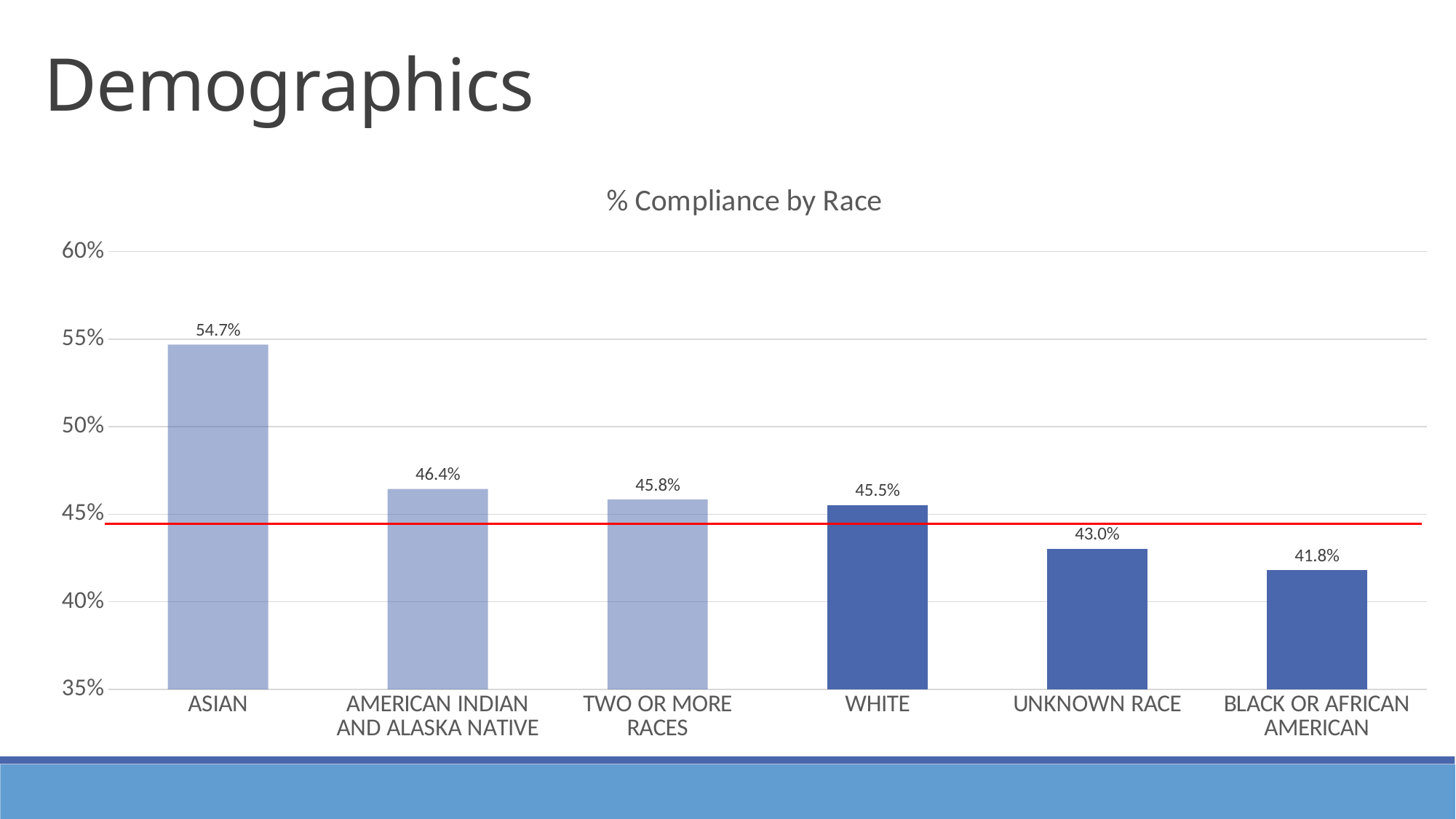
What is the title of the chart? % Compliance by Race What kind of chart is shown on the slide? Bar chart What is the % compliance value for BLACK OR AFRICAN AMERICAN? 41.8% What is the % compliance value for UNKNOWN RACE? 43.0% Is the value for TWO OR MORE RACES greater or less than 45%? greater Which has a higher % compliance, AMERICAN INDIAN AND ALASKA NATIVE or UNKNOWN RACE? AMERICAN INDIAN AND ALASKA NATIVE Which race category has the lowest % compliance? BLACK OR AFRICAN AMERICAN Which race category has the highest % compliance? ASIAN What is the % compliance value for WHITE? 45.5% What is the % compliance value for ASIAN? 54.7% How many race categories are shown in the chart? 6 What is the difference in % compliance between ASIAN and BLACK OR AFRICAN AMERICAN? 12.9%